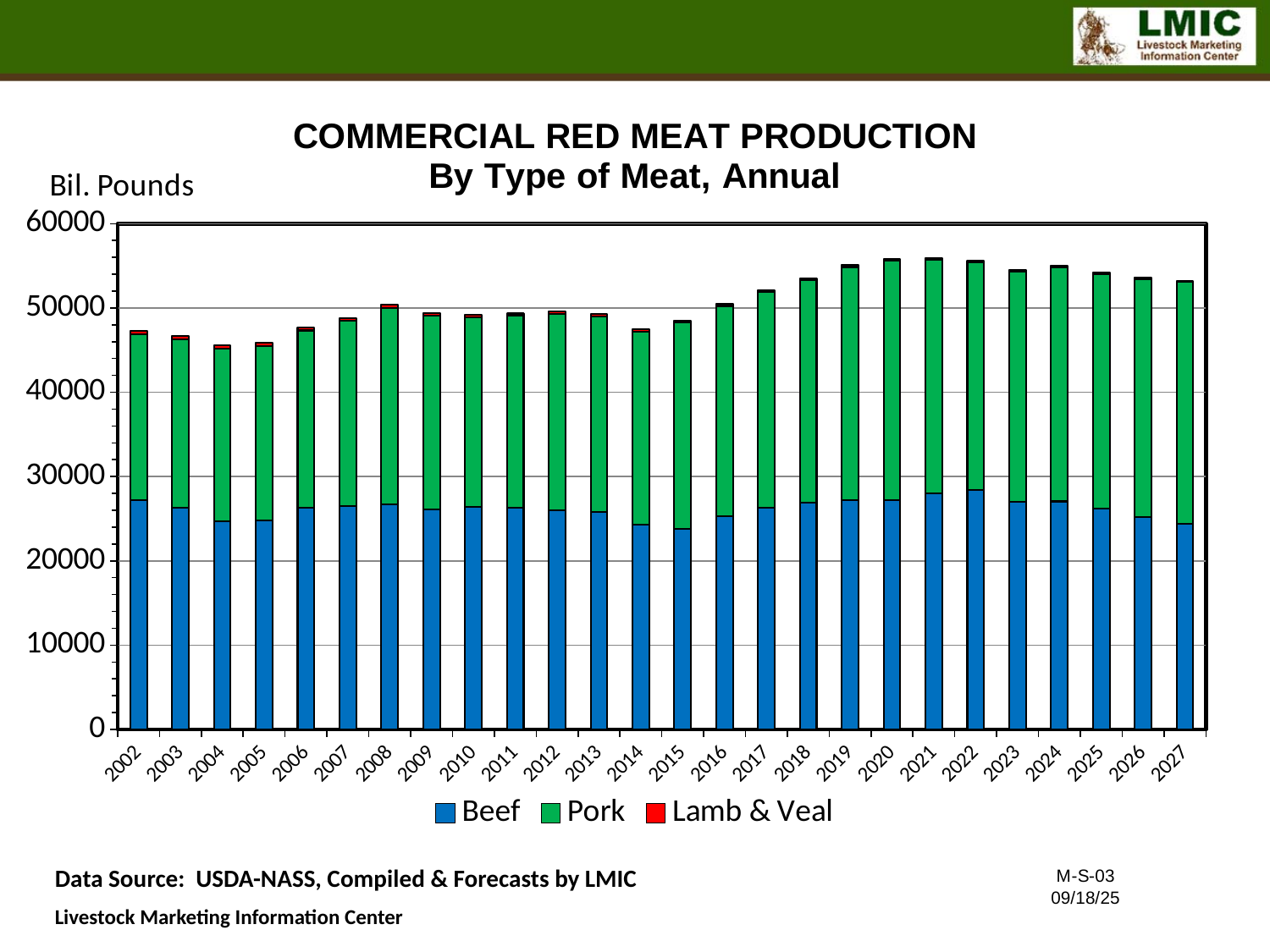
Is the Beef value for 2022 greater or less than 20000? greater Does total red meat production rise or fall from 2014 to 2021? rise How many series does the legend list? 3 How many years are shown along the x axis? 26 Which series is shown in green in the legend? Pork Is the total red meat production for 2021 greater or less than 50000? greater Is the total red meat production for 2004 greater or less than 50000? less What unit is shown on the y axis label? Bil. Pounds What kind of chart is shown on the slide? Stacked bar chart Which year has the larger total red meat production, 2004 or 2021? 2021 Which year has the larger Beef value, 2015 or 2022? 2022